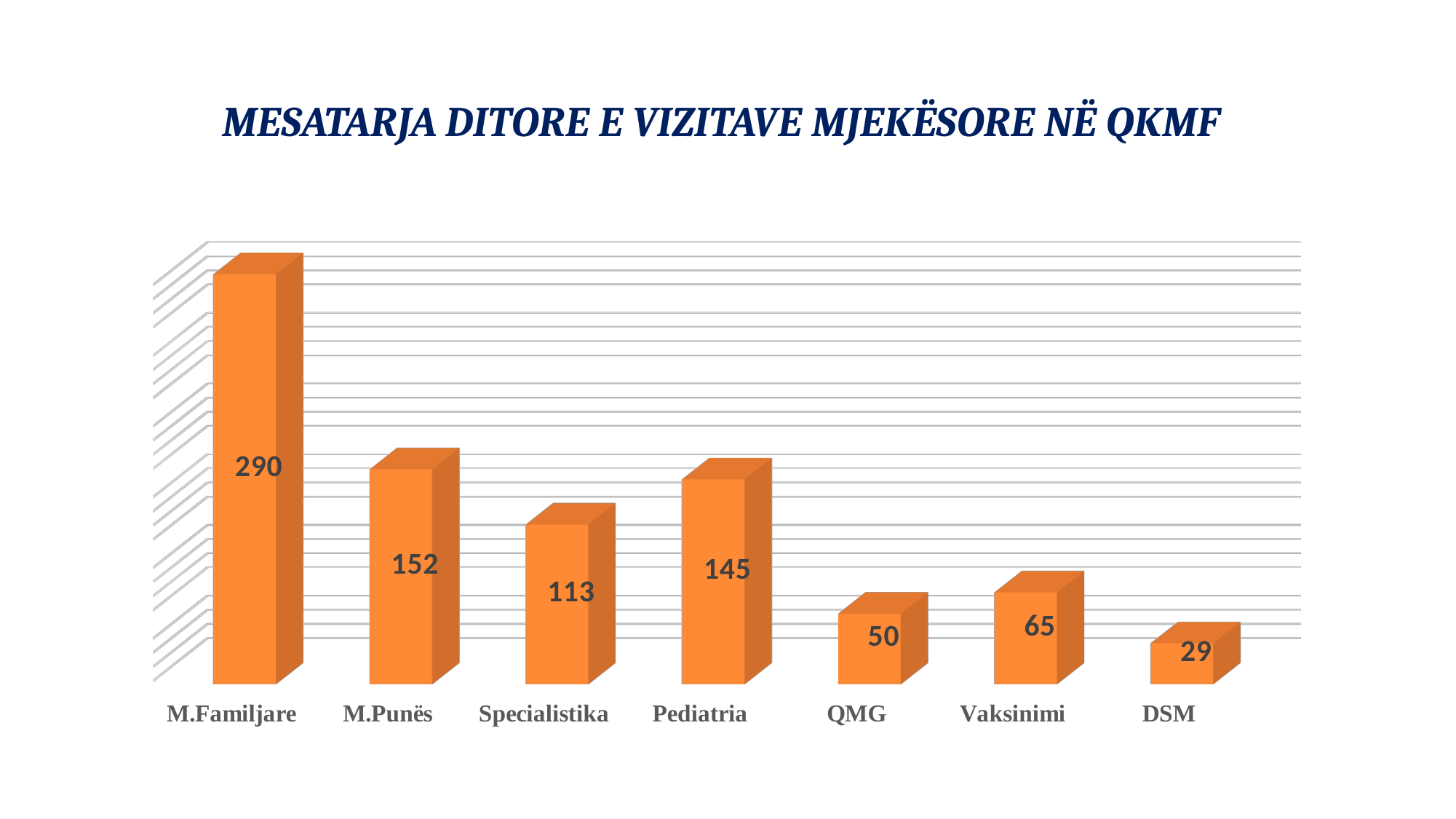
What kind of chart is shown on the slide? Bar chart What is the title of the chart? MESATARJA DITORE E VIZITAVE MJEKËSORE NË QKMF What is the value for M.Familjare? 290 What is the value for DSM? 29 Which is larger, the value for Specialistika or the value for Pediatria? Pediatria How many categories are shown in the chart? 7 What is the value for Vaksinimi? 65 Which category has the highest value? M.Familjare What is the difference between the values for Vaksinimi and QMG? 15 What is the difference between the values for M.Familjare and M.Punës? 138 What is the value for Pediatria? 145 Which category has the lowest value? DSM